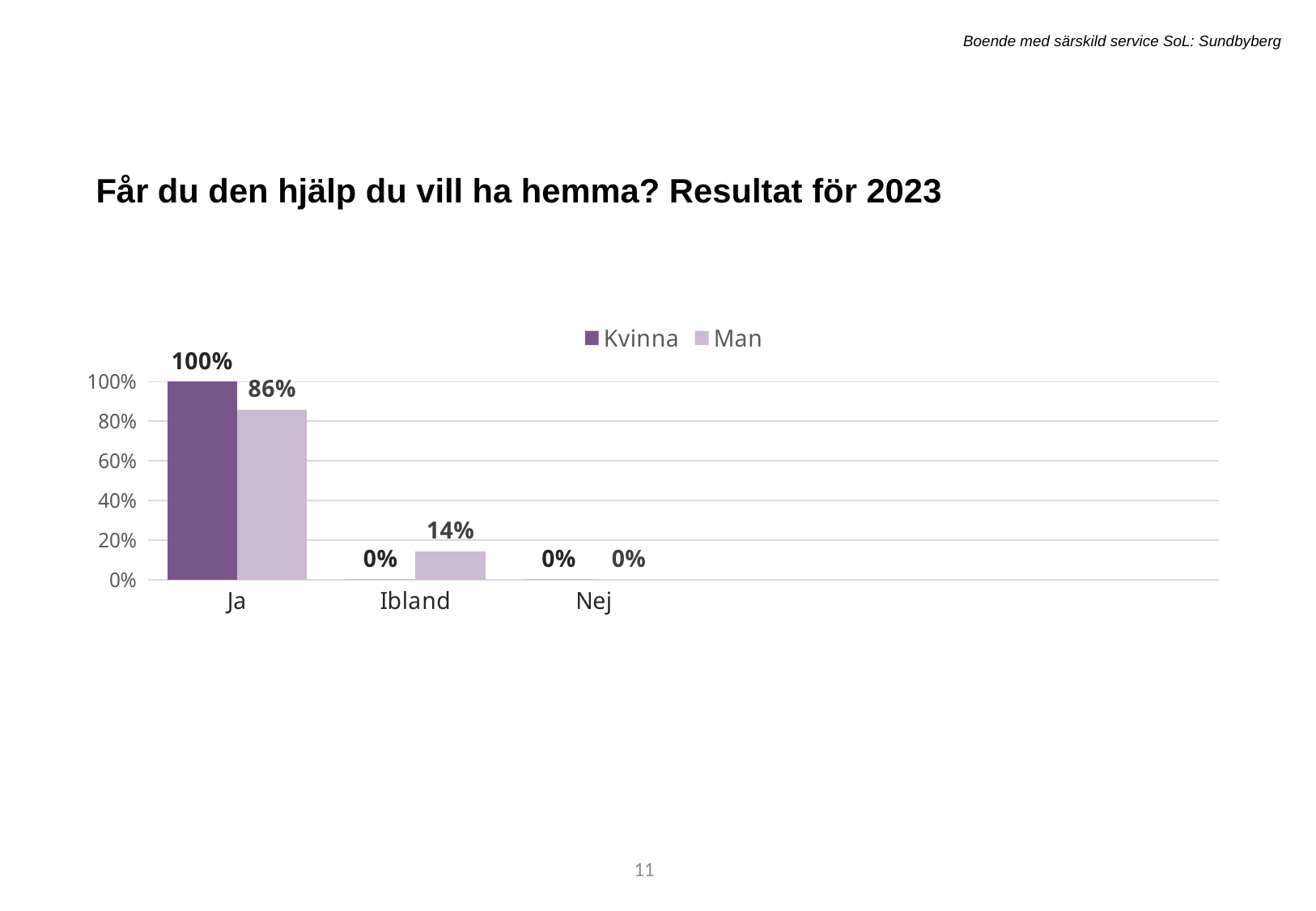
What is the value for Man in the Nej category? 0% How many series does the legend list? 2 What is the value for Kvinna in the Ibland category? 0% What is the value for Kvinna in the Ja category? 100% Which is larger in the Ja category, the value for Kvinna or the value for Man? Kvinna What is the value for Man in the Ja category? 86% How many categories are shown on the x axis? 3 What is the title of the chart on the slide? Får du den hjälp du vill ha hemma? Resultat för 2023 Which category has the highest value for Man? Ja What is the value for Man in the Ibland category? 14% What kind of chart is shown on the slide? Bar chart What is the difference between the Kvinna and Man values in the Ja category? 14%